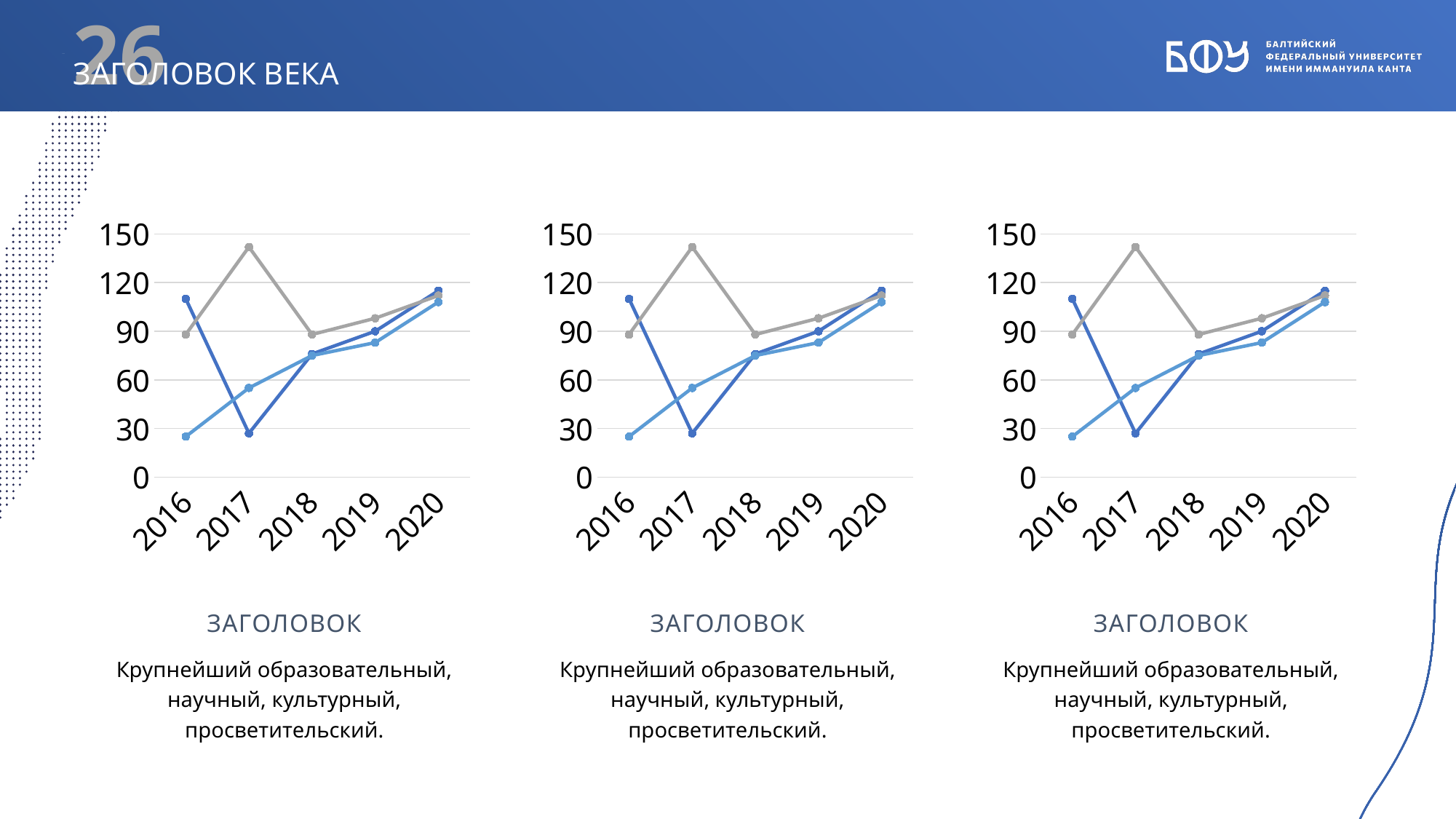
In the middle chart, is the value of the dark blue line for 2017 greater or less than 60? less What kind of chart is the left chart on the slide? line chart In the right chart, is the value of the light blue line for 2016 greater or less than 60? less How many lines are plotted in the right chart? 3 What is the highest value labelled on the y axis of the left chart? 150 In the middle chart, in which year does the dark blue line reach its lowest value? 2017 In the left chart, is the value of the gray line for 2017 greater or less than 120? greater How many years are shown on the x axis of the middle chart? 5 In the left chart, in which year does the gray line reach its highest value? 2017 In the right chart, does the light blue line rise or fall from 2016 to 2020? rise In the left chart, which line has the higher value in 2016, the gray line or the dark blue line? the dark blue line